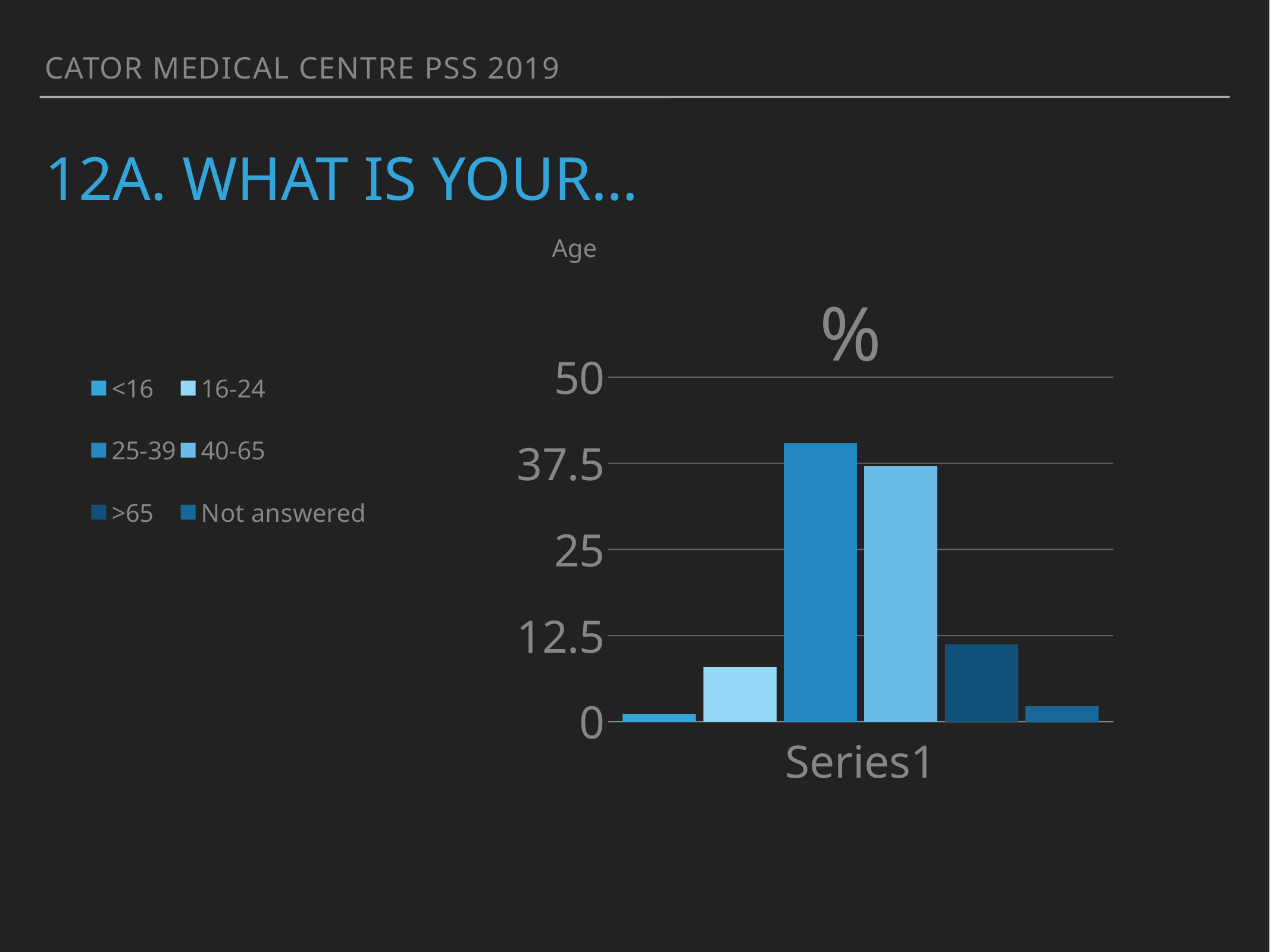
What kind of chart is shown on the slide? bar chart How many entries does the chart's legend list? 6 What is the title shown above the chart's plot area? % Which is larger, the value for 25-39 or the value for 16-24? 25-39 Is the value for 16-24 greater or less than 12.5? less Which age group has the tallest bar in the chart? 25-39 Is the value for Not answered greater or less than 12.5? less Is the value for 40-65 greater or less than 25? greater Which is larger, the value for 16-24 or the value for >65? >65 Which age group has the shortest bar in the chart? <16 How many bars are plotted in the chart? 6